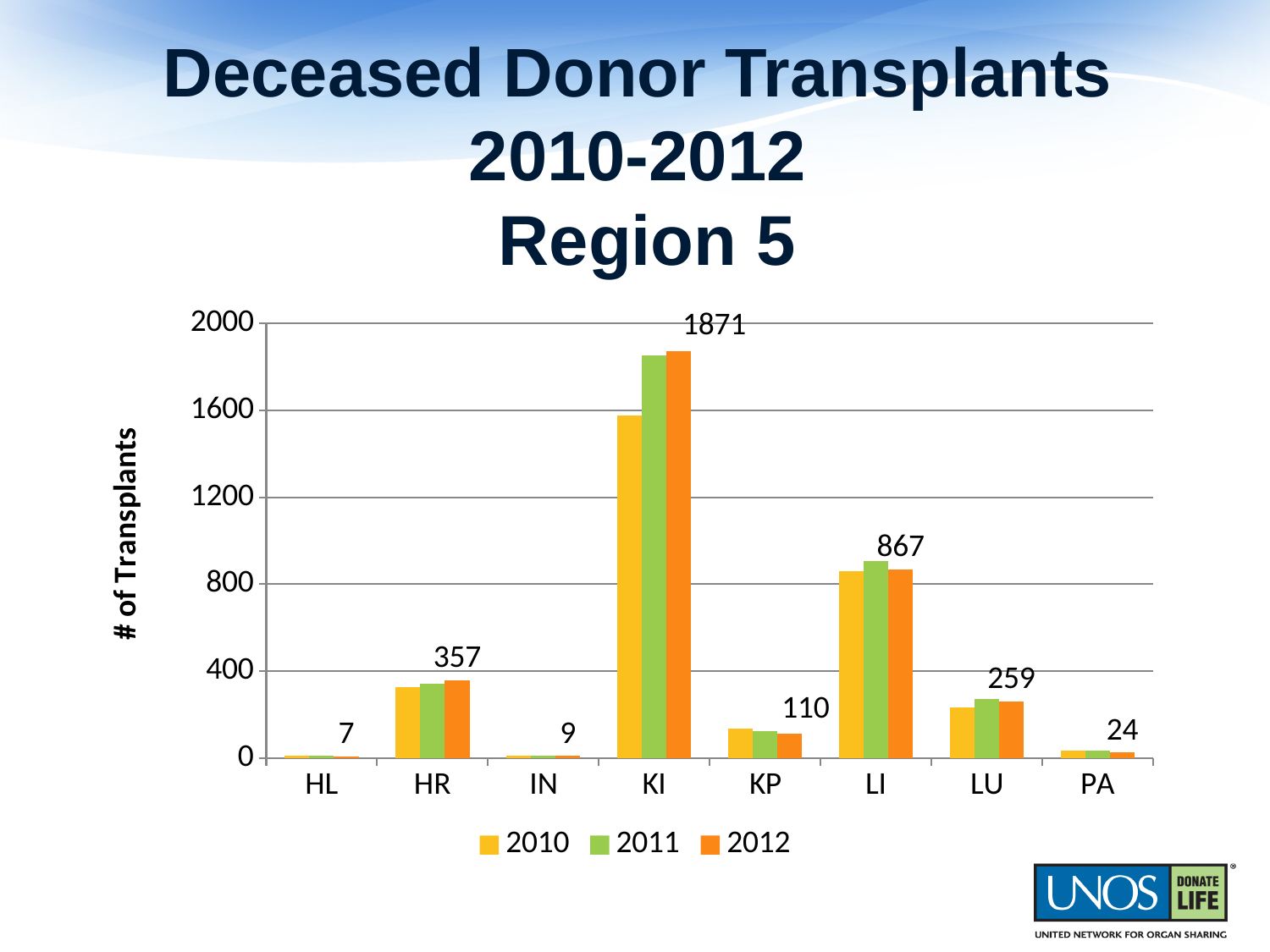
Which is larger in 2012, HR or LU? HR What is the difference between the 2012 values for KI and LI? 1004 What is the value for KI in 2012? 1871 Which organ category has the lowest number of transplants in 2012? HL What is the value for HR in 2012? 357 How many series does the legend list? 3 What is the value for PA in 2012? 24 Is the value for KI in 2010 greater or less than 1200? greater What is the value for LI in 2012? 867 What kind of chart is shown on the slide? bar chart How many organ categories are shown on the x axis? 8 Which organ category has the highest number of transplants? KI